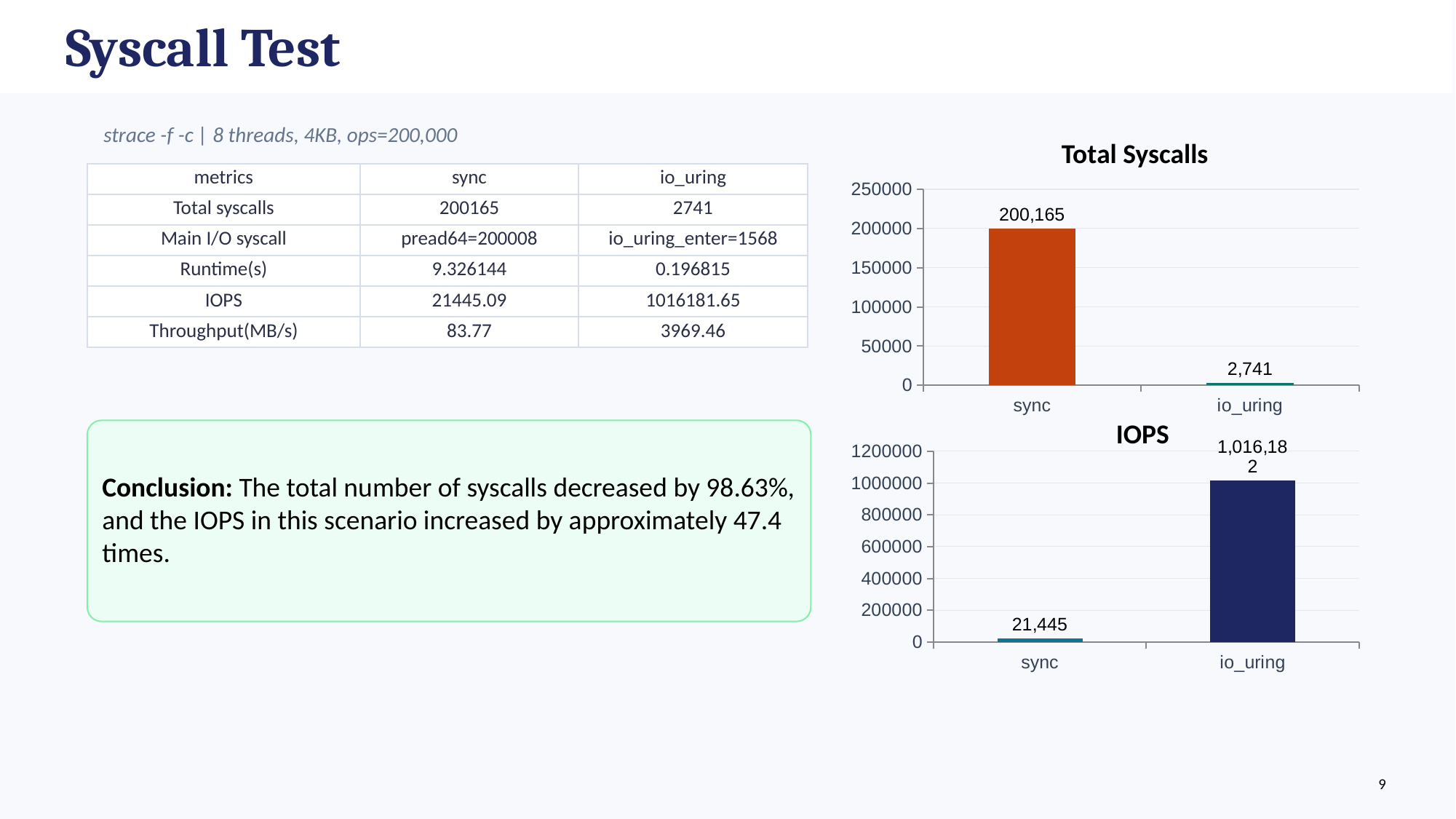
What kind of chart is the IOPS chart? bar chart In the Total Syscalls chart, which category has the highest value? sync In the IOPS chart, what is the value for sync? 21,445 In the Total Syscalls chart, what is the difference between the sync and io_uring values? 197,424 In the Total Syscalls chart, what is the value for sync? 200,165 In the Total Syscalls chart, what is the value for io_uring? 2,741 In the IOPS chart, what is the value for io_uring? 1,016,182 In the Total Syscalls chart, what colour is the sync bar? orange In the IOPS chart, is the value for io_uring greater or less than 800000? greater In the IOPS chart, which category has the lowest value? sync In the IOPS chart, what is the difference between the io_uring and sync values? 994,737 How many categories are shown in the Total Syscalls chart? 2